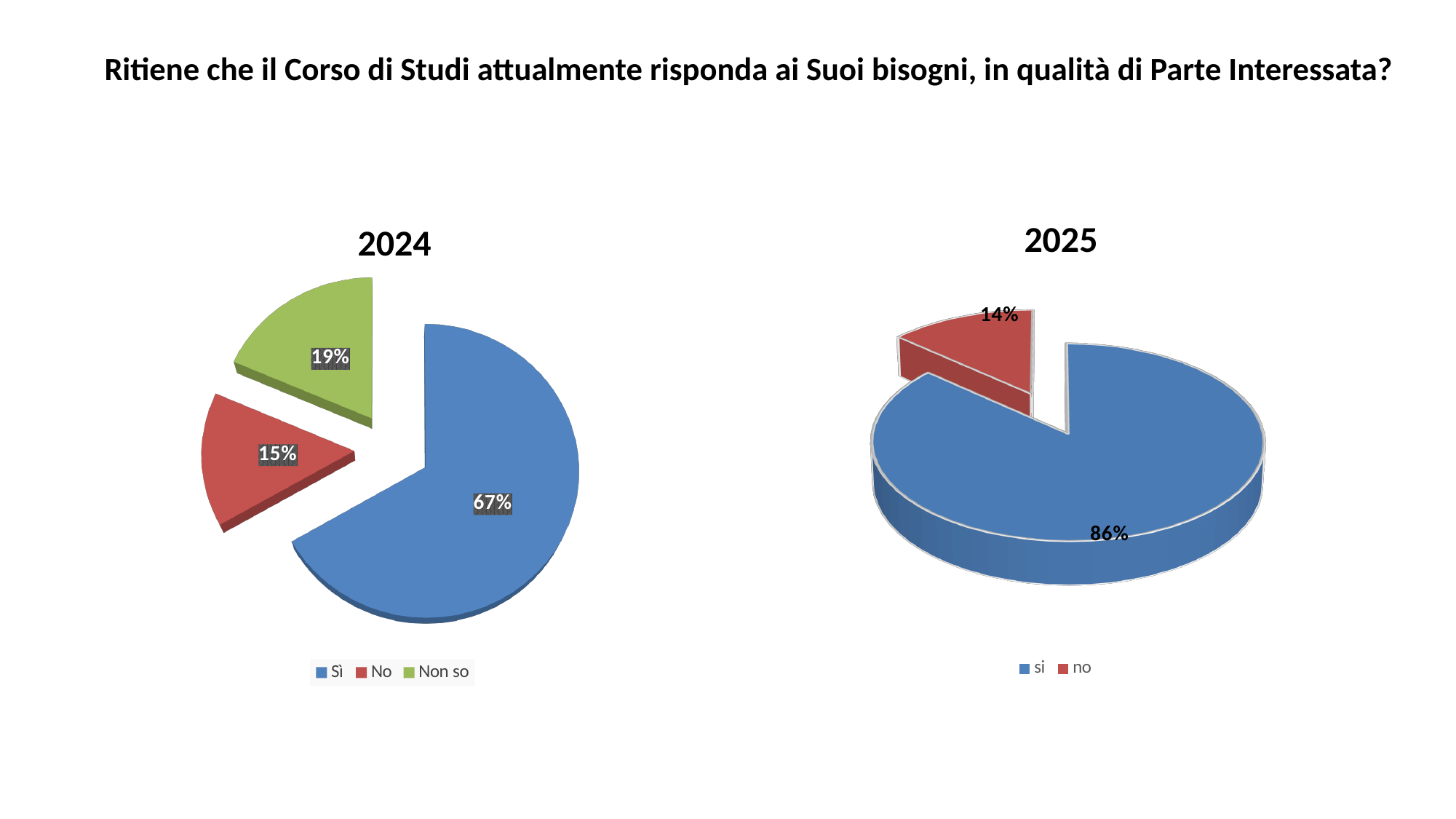
In the 2025 chart, what share of responses is "si"? 86% In the 2024 chart, what is the difference between the "Sì" share and the "No" share? 52% In the 2024 chart, which category has the largest slice? Sì In the 2024 chart, what share of responses is "Sì"? 67% In the 2024 chart, which category has the smallest slice? No What kind of chart is the 2025 chart? pie chart In the 2024 chart, what share of responses is "Non so"? 19% In the 2024 chart, what share of responses is "No"? 15% In the 2025 chart, what share of responses is "no"? 14% Is the "Sì" share in the 2024 chart larger or smaller than the "si" share in the 2025 chart? smaller In the 2025 chart, what is the difference between the "si" share and the "no" share? 72% How many categories does the legend of the 2024 chart list? 3